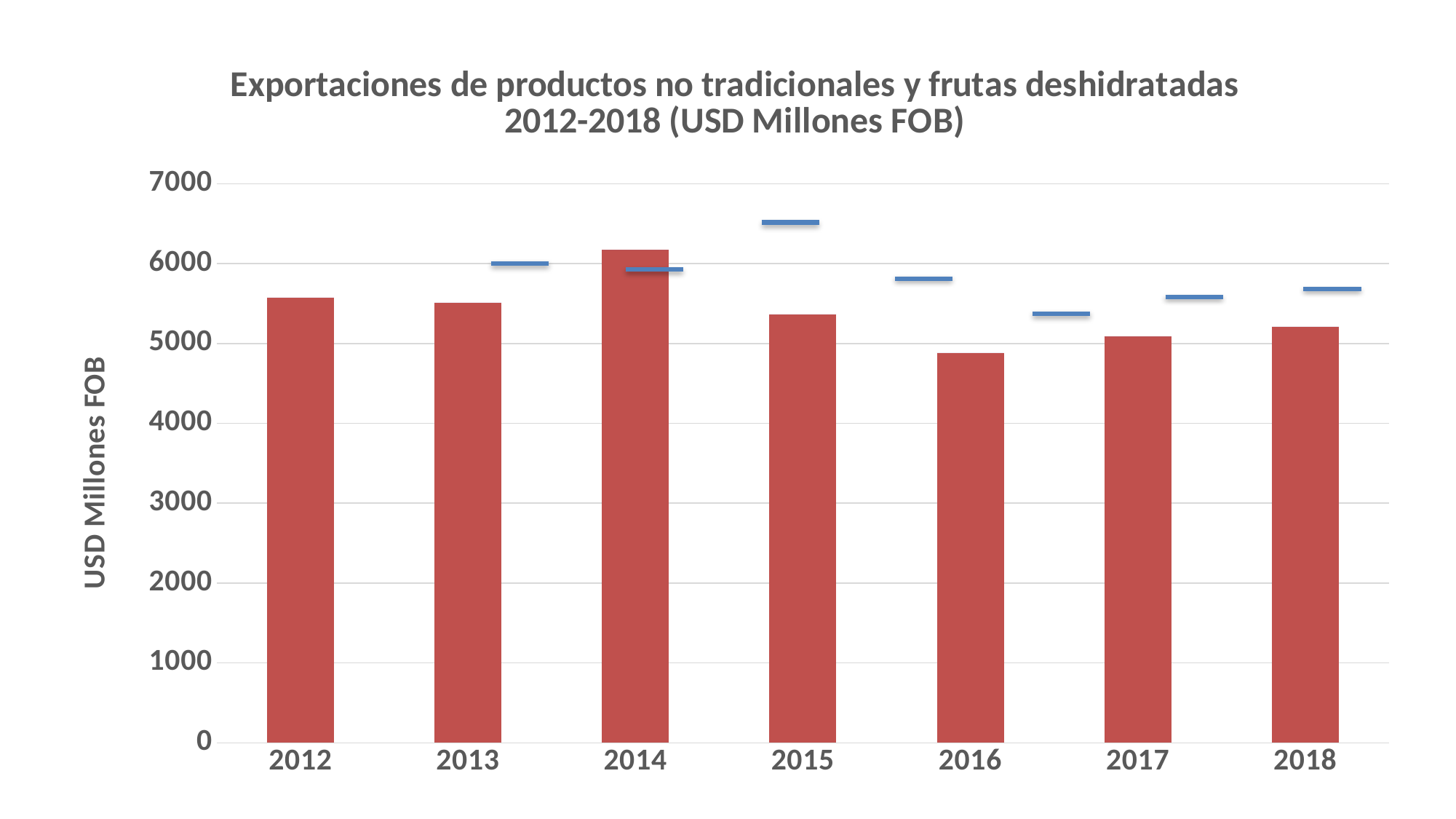
How many years are shown on the x axis of the chart? 7 What kind of chart is shown on the slide? bar chart Is the value of the red bar for 2012 greater or less than 5000? greater Which year has the shortest red bar? 2016 Do the red bars rise or fall from 2014 to 2016? fall Is the blue marker for 2015 greater or less than 6000? greater Is the value of the red bar for 2014 greater or less than 6000? greater Which red bar is taller, 2014 or 2015? 2014 Which red bar is taller, 2016 or 2017? 2017 Which year has the tallest red bar? 2014 What is the label on the vertical axis of the chart? USD Millones FOB